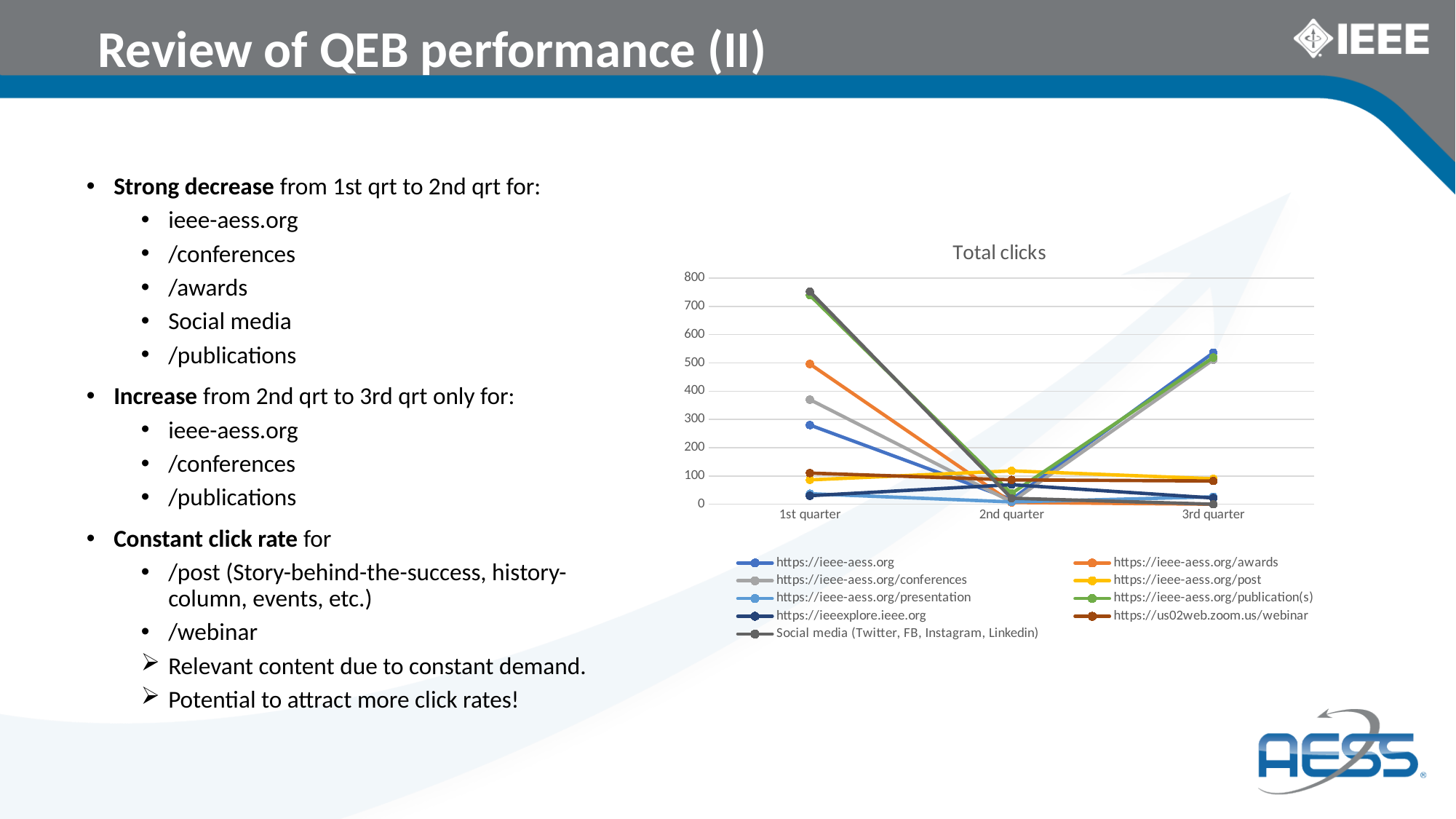
Is the value for https://ieee-aess.org in the 1st quarter greater or less than 400? less In the 3rd quarter, which is larger: https://ieee-aess.org or https://ieee-aess.org/awards? https://ieee-aess.org What is the title of the chart? Total clicks How many quarters are shown on the x axis of the chart? 3 Is the value for https://ieee-aess.org/awards in the 1st quarter greater or less than 400? greater How many series does the chart legend list? 9 Is the value for Social media (Twitter, FB, Instagram, Linkedin) in the 1st quarter greater or less than 700? greater Does the value for https://ieee-aess.org/awards rise or fall from the 1st quarter to the 3rd quarter? fall In the 1st quarter, which is larger: https://ieee-aess.org/awards or https://ieee-aess.org? https://ieee-aess.org/awards What kind of chart is shown on the slide? line chart